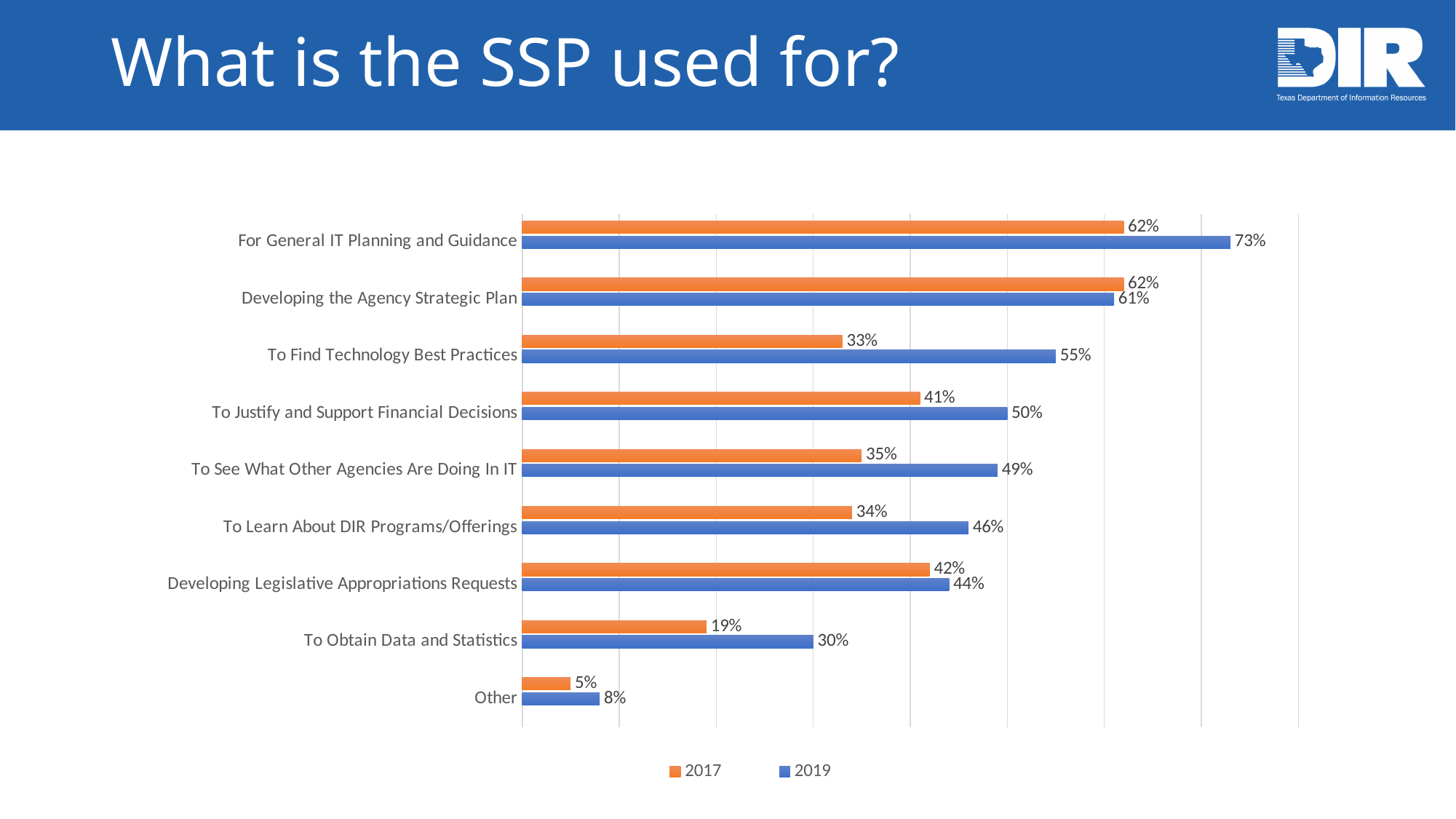
What is the 2019 value for To Learn About DIR Programs/Offerings? 46% What is the difference between the 2019 and 2017 values for For General IT Planning and Guidance? 11% How many series does the legend list? 2 Which category has the lowest 2017 value? Other What kind of chart is shown on the slide? Bar chart How many categories are shown on the chart? 9 Which colour represents the 2017 series? Orange What is the 2019 value for To Find Technology Best Practices? 55% What is the difference between the 2019 and 2017 values for To Find Technology Best Practices? 22% Which category has the highest 2019 value? For General IT Planning and Guidance Which is larger for To See What Other Agencies Are Doing In IT, the 2017 value or the 2019 value? 2019 What is the 2017 value for To Obtain Data and Statistics? 19%